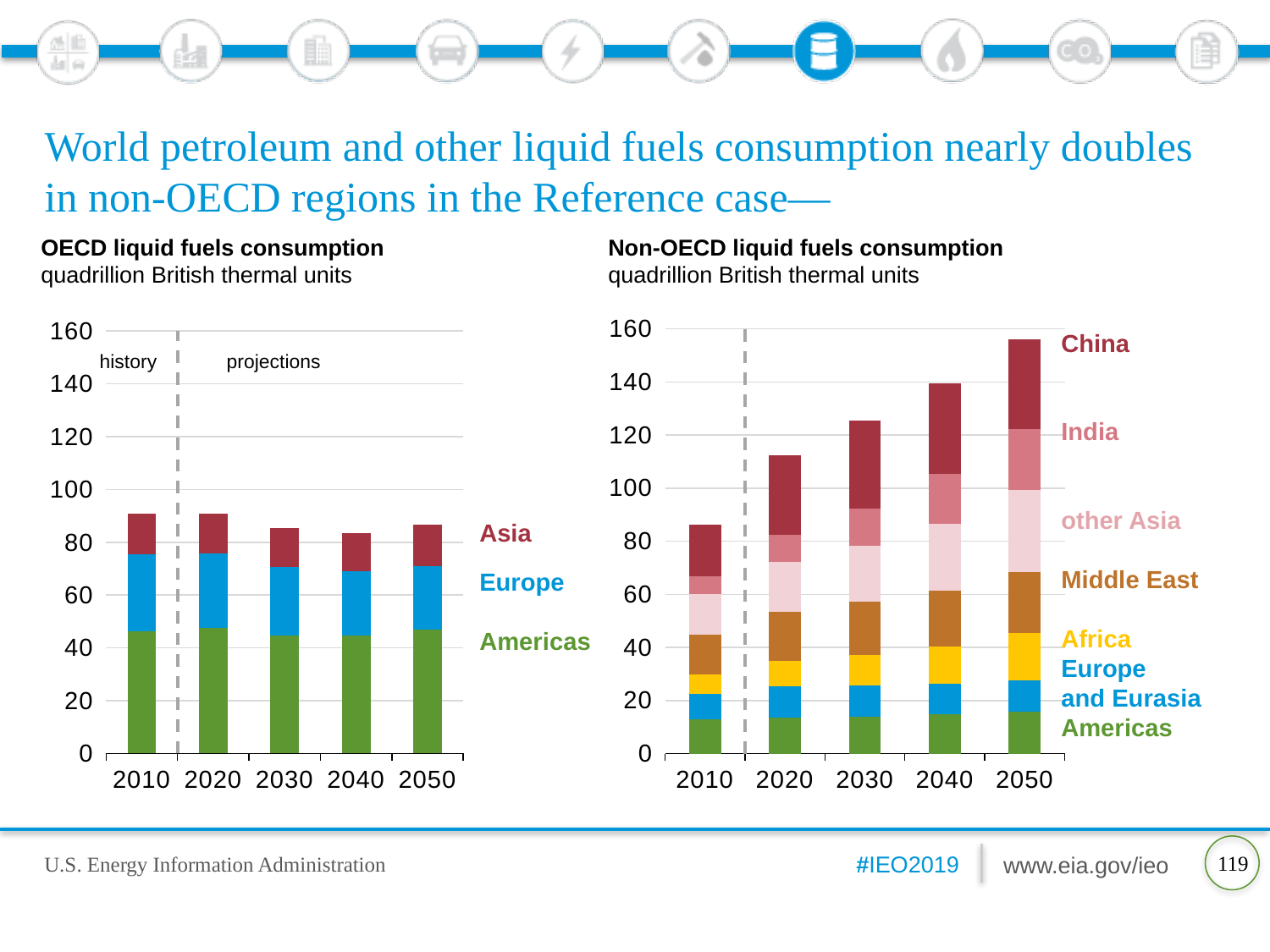
Which is larger: the total for 2050 in the Non-OECD chart or the total for 2050 in the OECD chart? Non-OECD In the OECD liquid fuels consumption chart, is the total for 2050 greater or less than 100? less In the Non-OECD liquid fuels consumption chart, which year has the lowest total consumption? 2010 In the Non-OECD liquid fuels consumption chart, is the total for 2050 greater or less than 140? greater How many years are shown on the x axis of the Non-OECD liquid fuels consumption chart? 5 What unit is given under the title of the OECD liquid fuels consumption chart? quadrillion British thermal units In the Non-OECD liquid fuels consumption chart, do total values rise or fall from 2010 to 2050? rise In the Non-OECD liquid fuels consumption chart, which is larger: the total for 2020 or the total for 2010? 2020 In the Non-OECD liquid fuels consumption chart, which year has the highest total consumption? 2050 How many regions does the legend of the Non-OECD liquid fuels consumption chart list? 7 What kind of chart is the OECD liquid fuels consumption chart? stacked bar chart How many regions does the legend of the OECD liquid fuels consumption chart list? 3